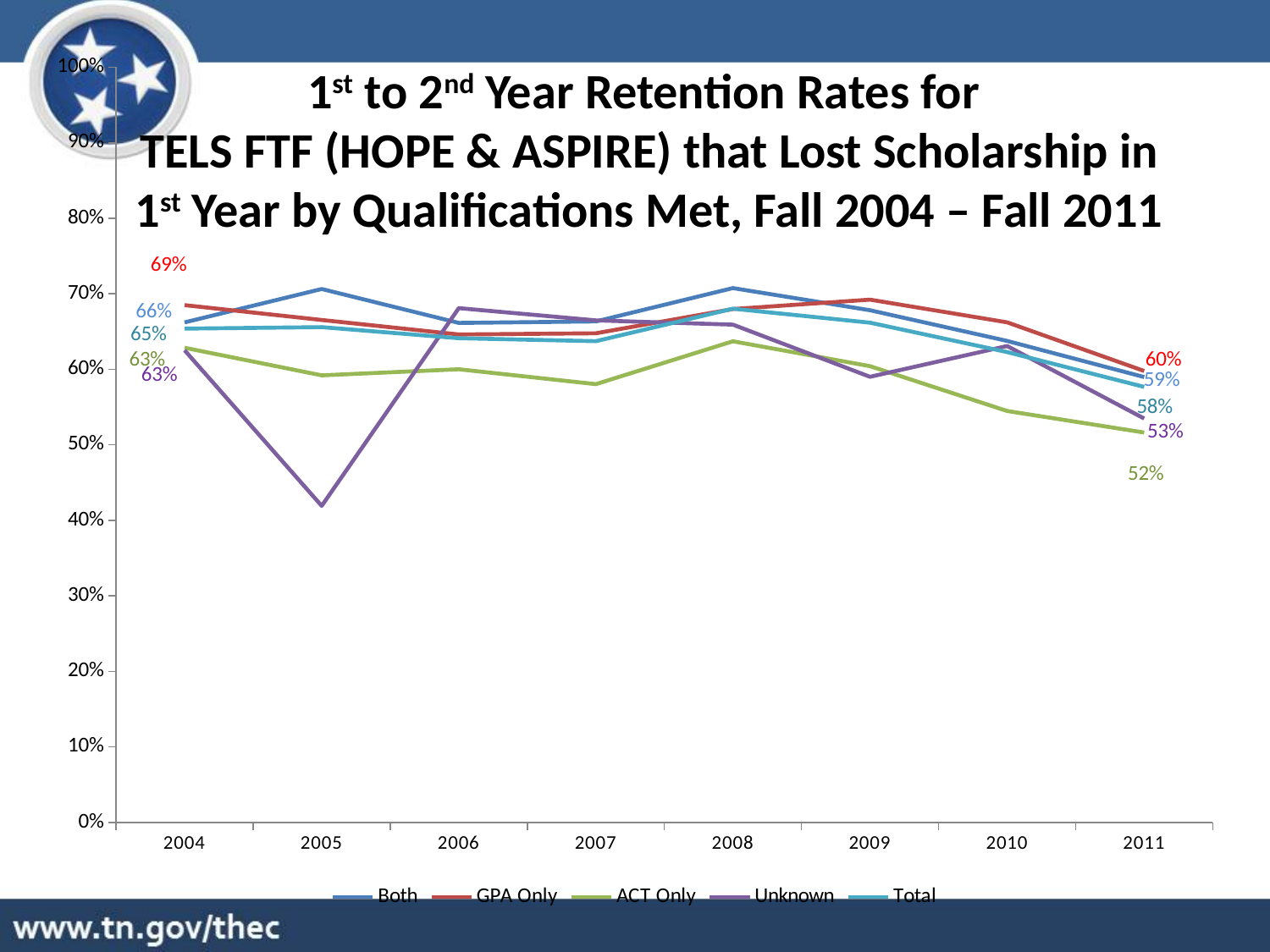
Which is larger in 2011, the value for Both or the value for Total? Both Which series has the highest retention rate in 2004? GPA Only By how many percentage points did the GPA Only retention rate fall from 2004 to 2011? 9 percentage points What is the retention rate for GPA Only in 2004? 69% What is the retention rate for ACT Only in 2011? 52% Which series has the lowest retention rate in 2011? ACT Only How many series does the legend list? 5 What is the retention rate for Total in 2004? 65% How many years are plotted along the x axis? 8 Is the value for Unknown in 2005 greater or less than 50%? less What kind of chart is shown on the slide? line chart What is the retention rate for Both in 2011? 59%